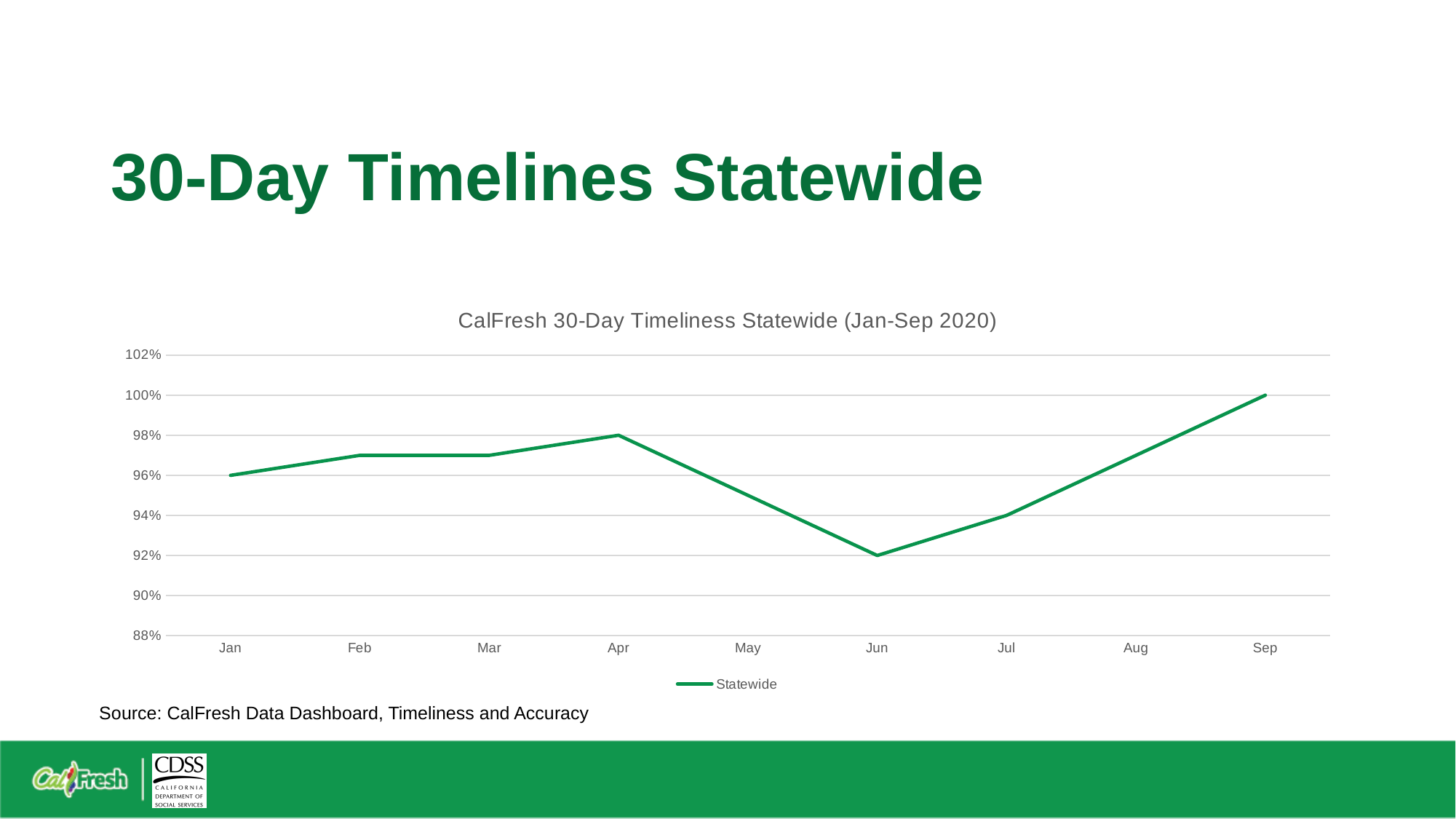
What is the difference between the Sep value and the Jun value? 8 percentage points What is the statewide 30-day timeliness value for Jan? 96% What is the statewide 30-day timeliness value for Jun? 92% Which month has the highest statewide timeliness value? Sep Is the value for May greater or less than 94%? greater What is the statewide 30-day timeliness value for Sep? 100% Does the statewide timeliness rise or fall from Jun to Sep? Rises Which month has the lowest statewide timeliness value? Jun Which is larger, the value for Apr or the value for Jul? Apr What type of chart is shown on the slide? Line chart How many months are plotted on the x axis of the chart? 9 How many series does the chart legend list? 1